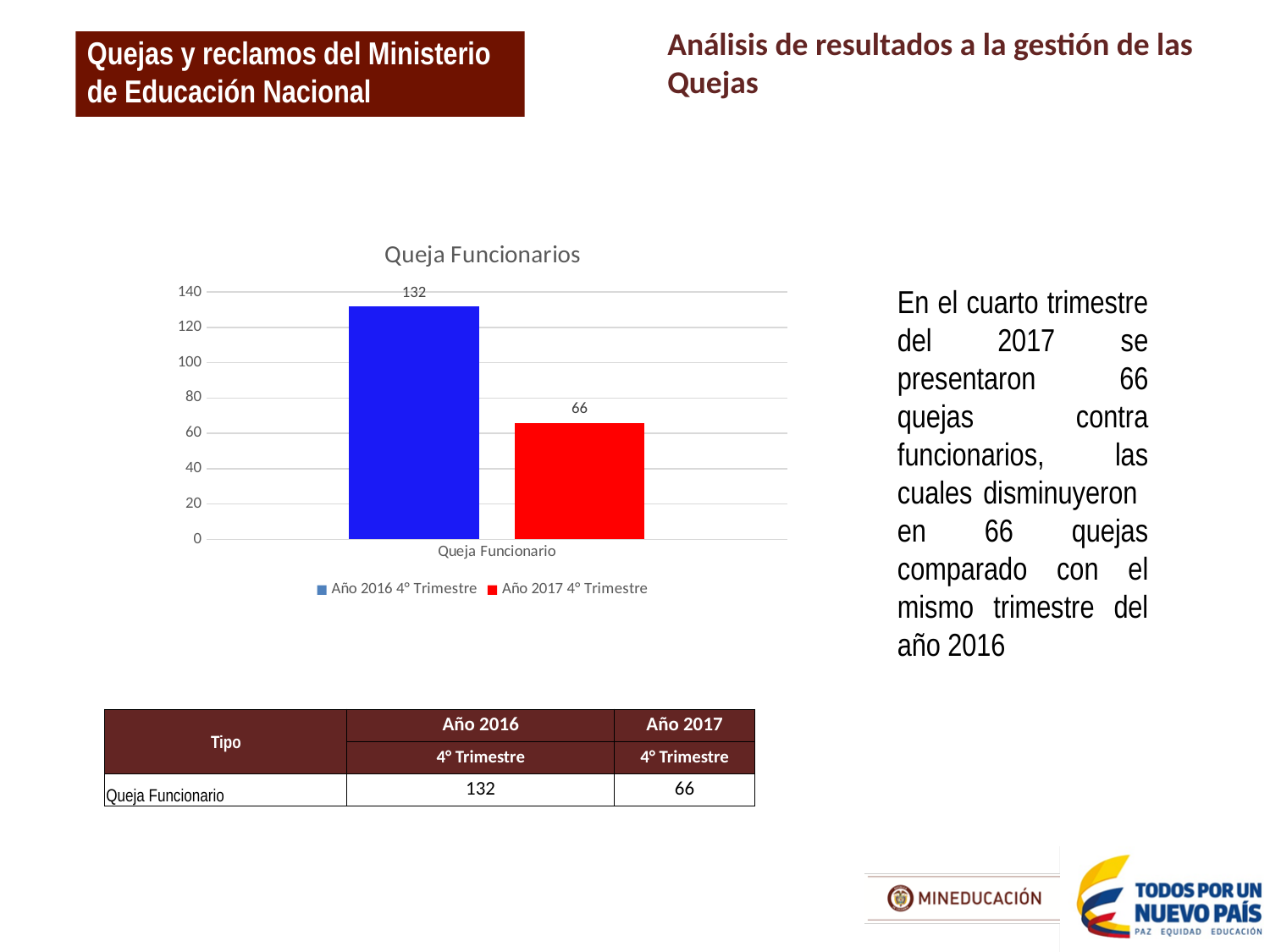
Which series has the lower value in the Queja Funcionarios chart? Año 2017 4º Trimestre Is the value for Año 2016 4º Trimestre larger or smaller than the value for Año 2017 4º Trimestre? larger What kind of chart is shown on the slide? bar chart Which series has the higher value in the Queja Funcionarios chart? Año 2016 4º Trimestre What is the value for Año 2017 4º Trimestre in the Queja Funcionarios chart? 66 What is the difference between the Año 2016 4º Trimestre and Año 2017 4º Trimestre values in the Queja Funcionarios chart? 66 What is the title of the chart on the slide? Queja Funcionarios What colour is the bar for Año 2017 4º Trimestre in the chart? red Is the value for Año 2016 4º Trimestre greater or less than 120? greater What is the value for Año 2016 4º Trimestre in the Queja Funcionarios chart? 132 Is the value for Año 2017 4º Trimestre greater or less than 80? less How many series does the legend of the Queja Funcionarios chart list? 2